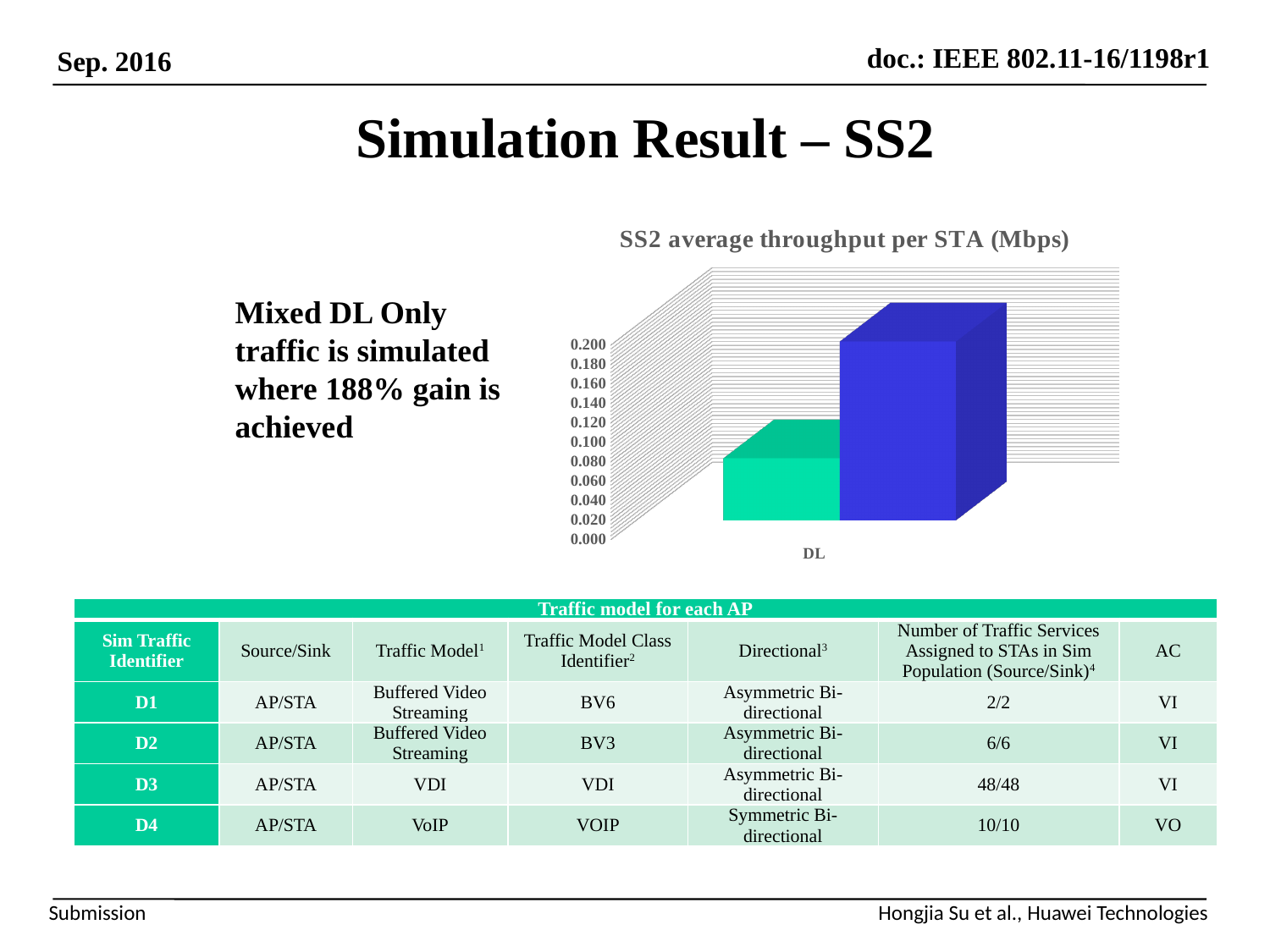
What is the label of the single category on the x axis of the chart? DL What is the highest tick value shown on the y axis of the chart? 0.200 Is the value of the green bar in the chart greater or less than 0.100? less Is the value of the blue bar in the chart greater or less than 0.140? greater Is the value of the blue bar in the chart greater or less than 0.160? greater Which bar is taller in the chart, the green bar or the blue bar? the blue bar How many categories are shown on the x axis of the chart? 1 What kind of chart is shown on the slide? bar chart How many bars are plotted in the chart? 2 What is the title of the chart? SS2 average throughput per STA (Mbps)